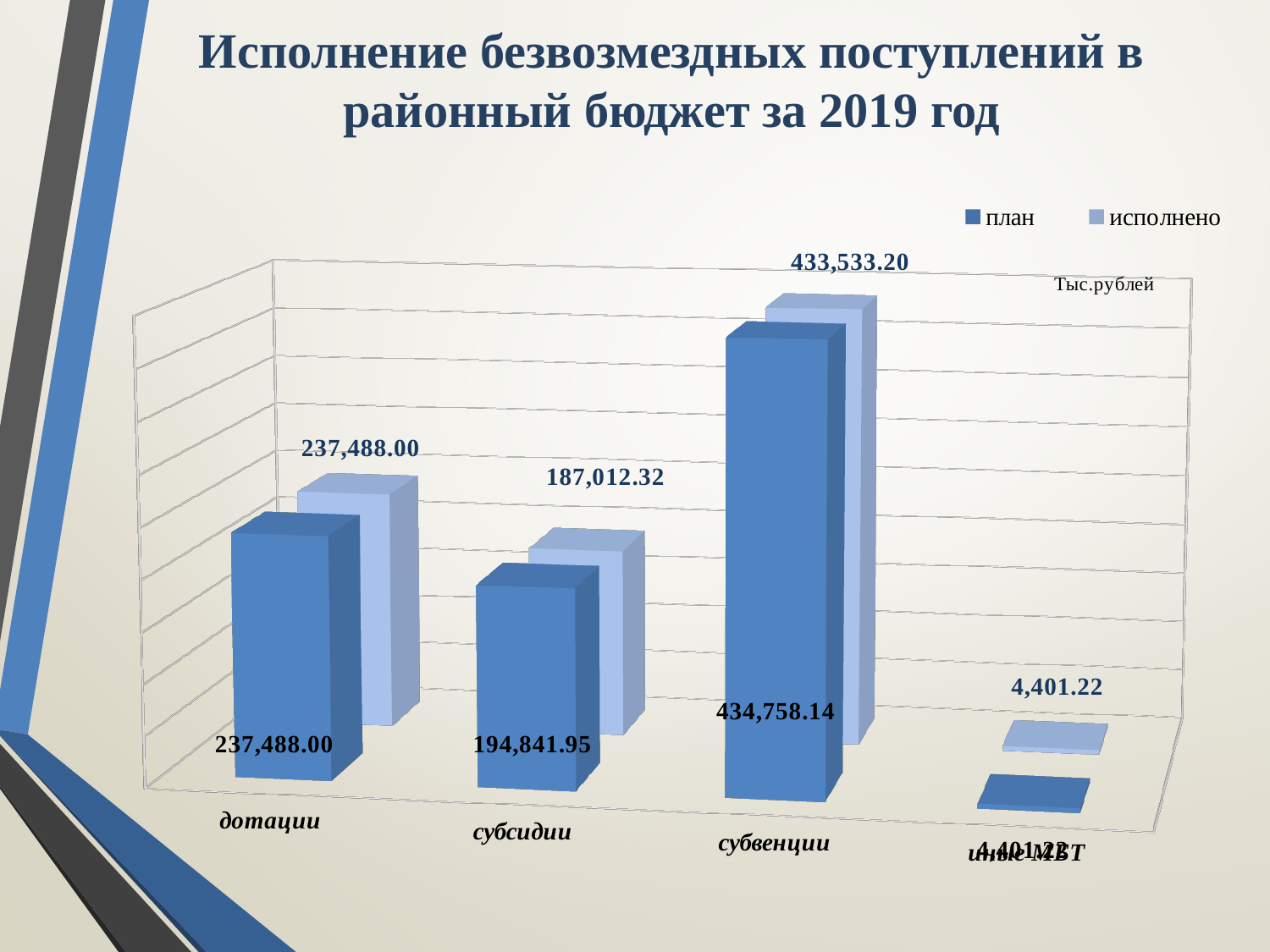
What is the исполнено value for субвенции? 433,533.20 Which is larger, the план value for дотации or the план value for субсидии? дотации How many series does the legend list? 2 Which category has the highest исполнено value? субвенции How many categories are shown on the x axis? 4 Which category has the lowest план value? иные МБТ What is the план value for субсидии? 194,841.95 What is the исполнено value for дотации? 237,488.00 What kind of chart is shown on the slide? bar chart What unit is indicated on the chart? Тыс.рублей What is the difference between the план and исполнено values for субсидии? 7,829.63 What is the исполнено value for иные МБТ? 4,401.22